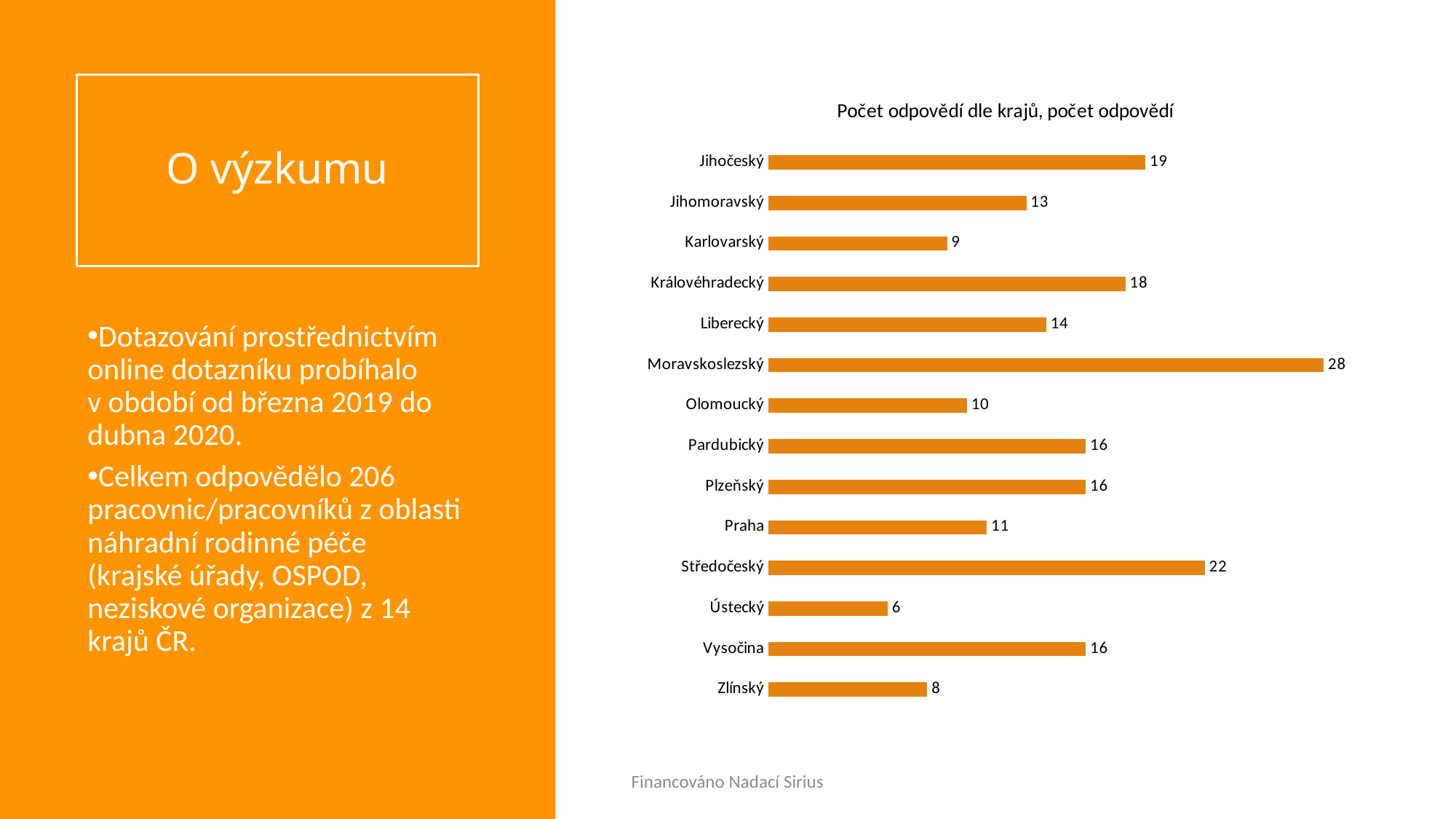
What is the value for Moravskoslezský? 28 Which is larger, the value for Královéhradecký or the value for Liberecký? Královéhradecký What is the difference between the values for Středočeský and Jihočeský? 3 Which region has the highest number of responses? Moravskoslezský What is the value for Karlovarský? 9 What is the value for Praha? 11 Which region has the lowest number of responses? Ústecký What kind of chart is shown on the slide? bar chart How many regions are shown in the chart? 14 How many regions have a value of 16? 3 What is the title of the chart? Počet odpovědí dle krajů, počet odpovědí What is the difference between the values for Moravskoslezský and Ústecký? 22